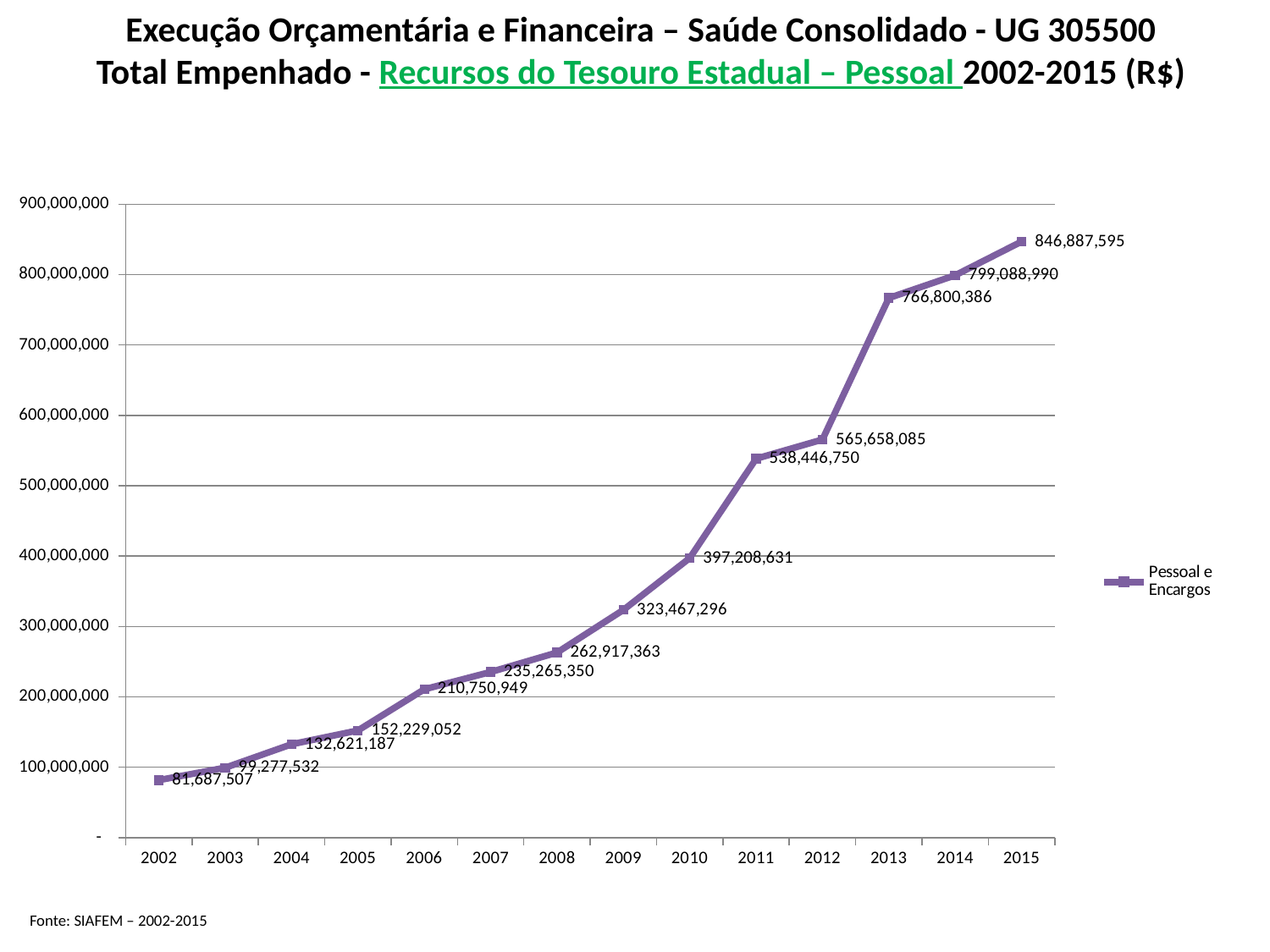
Is the value for 2013 greater or less than 700,000,000? greater Which is larger, the value for 2011 or the value for 2009? 2011 Which year has the lowest value? 2002 Which year has the highest value? 2015 How many years are plotted on the chart? 14 What is the value for 2010? 397,208,631 What kind of chart is shown? line chart What is the difference between the values for 2015 and 2014? 47,798,605 What is the difference between the values for 2013 and 2012? 201,142,301 What is the value for 2015? 846,887,595 What is the value for 2002? 81,687,507 What is the value for 2006? 210,750,949